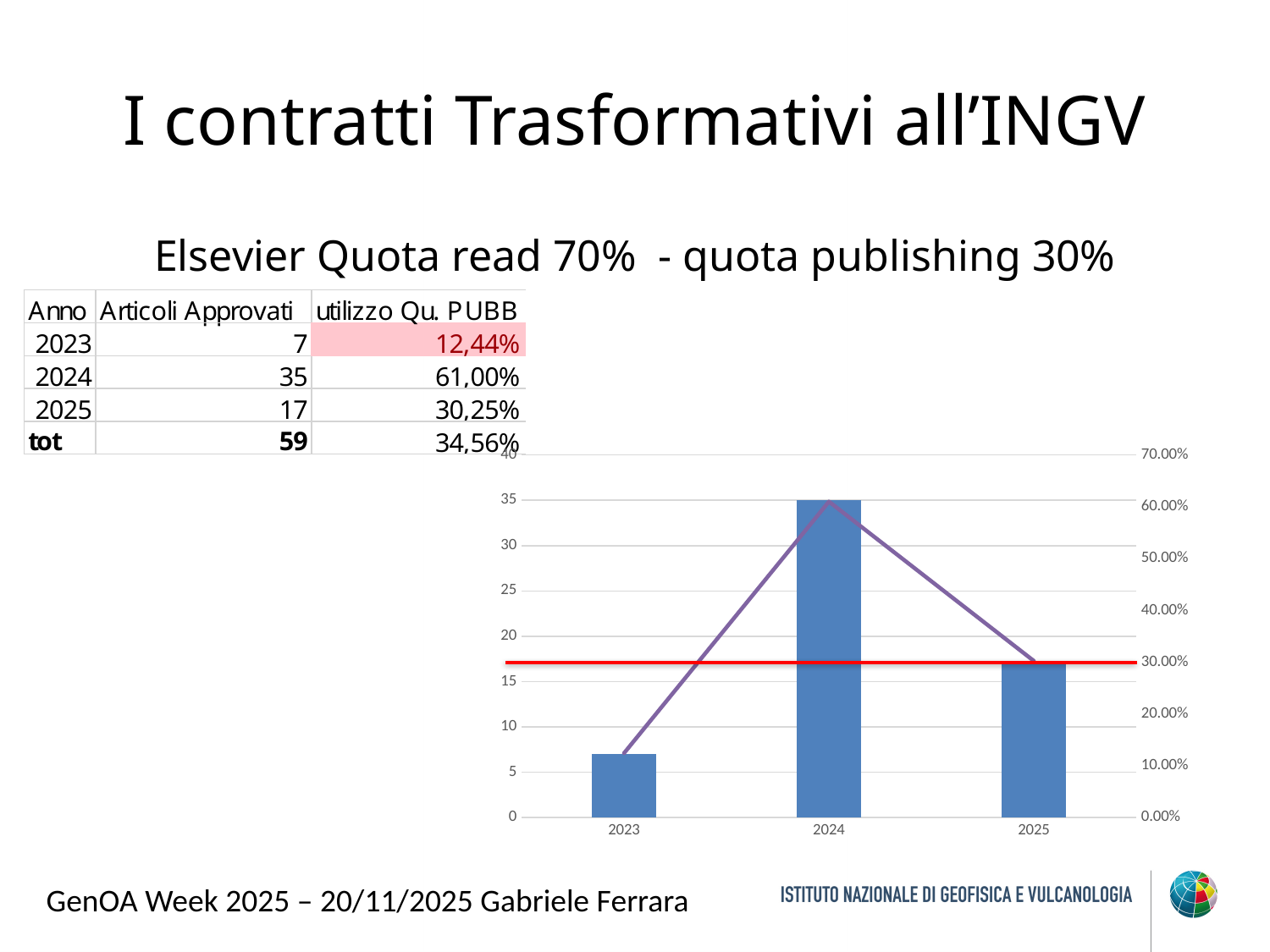
What kind of chart is shown on the slide? bar chart with a line What is the bar value for 2025 in the chart? 17 Is the bar value for 2025 greater or less than 20? less Which year has the shortest bar in the chart? 2023 What is the bar value for 2024 in the chart? 35 What is the bar value for 2023 in the chart? 7 What is the difference between the bar values for 2024 and 2025? 18 Which year has the tallest bar in the chart? 2024 Does the line in the chart rise or fall from 2024 to 2025? fall How many years are shown on the x axis of the chart? 3 Is the bar for 2025 larger or smaller than the bar for 2023? larger At what percentage on the right-hand axis is the red horizontal line drawn? 30.00%